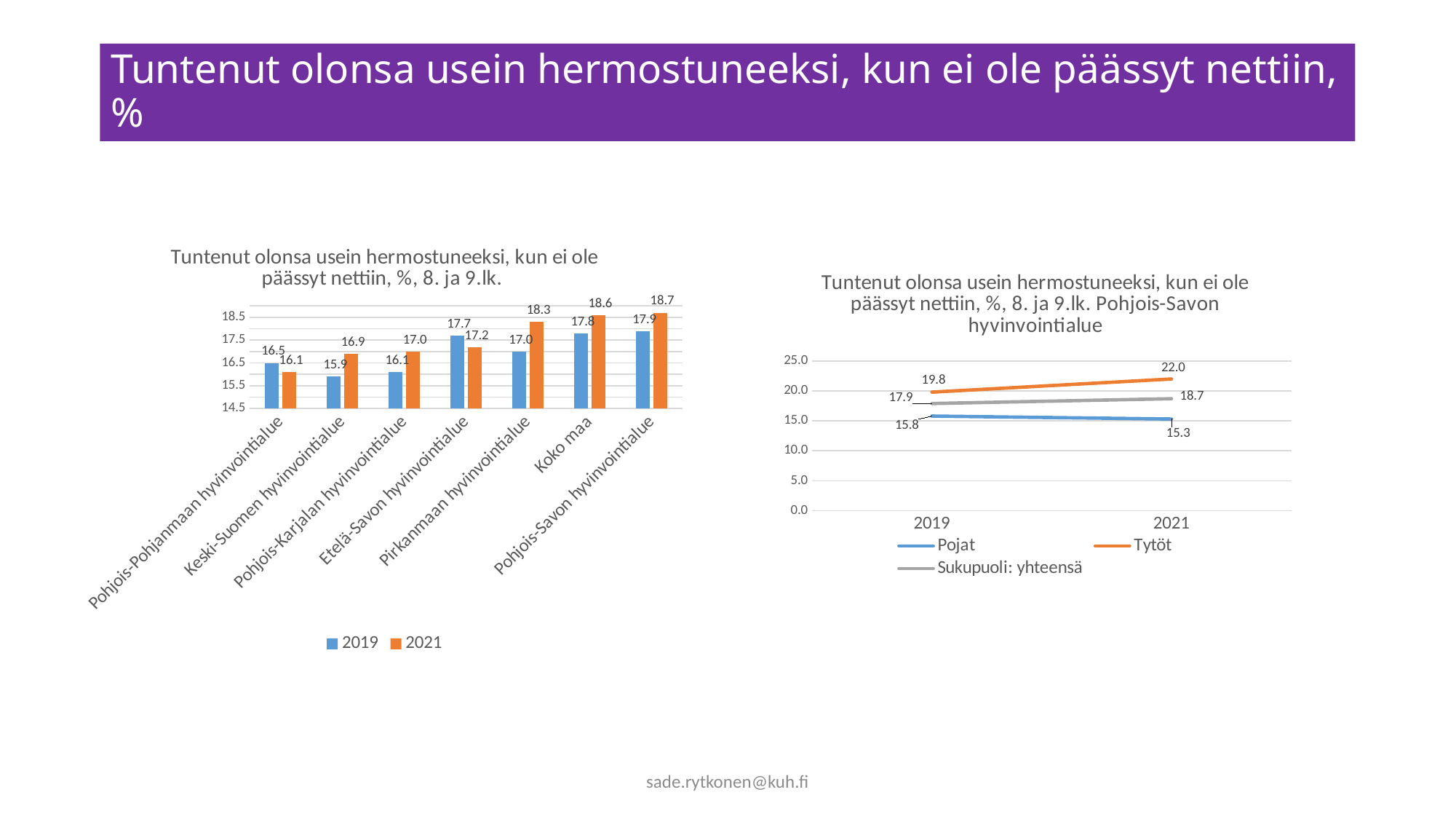
In the left chart, what is the difference between the 2021 and 2019 values for Pirkanmaan hyvinvointialue? 1.3 What type of chart is the left chart? Bar chart In the left chart, which category has the lowest 2019 value? Keski-Suomen hyvinvointialue In the right chart, does the value for Pojat rise or fall from 2019 to 2021? Fall In the left chart, is the 2019 value or the 2021 value larger for Etelä-Savon hyvinvointialue? 2019 In the right chart, what is the difference between the Tytöt and Pojat values in 2019? 4.0 In the left chart, what is the 2019 value for Keski-Suomen hyvinvointialue? 15.9 How many categories are shown on the x axis of the left chart? 7 In the left chart, which category has the highest 2021 value? Pohjois-Savon hyvinvointialue In the right chart, what is the value for Tytöt in 2021? 22.0 In the left chart, what is the 2021 value for Pohjois-Savon hyvinvointialue? 18.7 How many series does the legend of the right chart list? 3